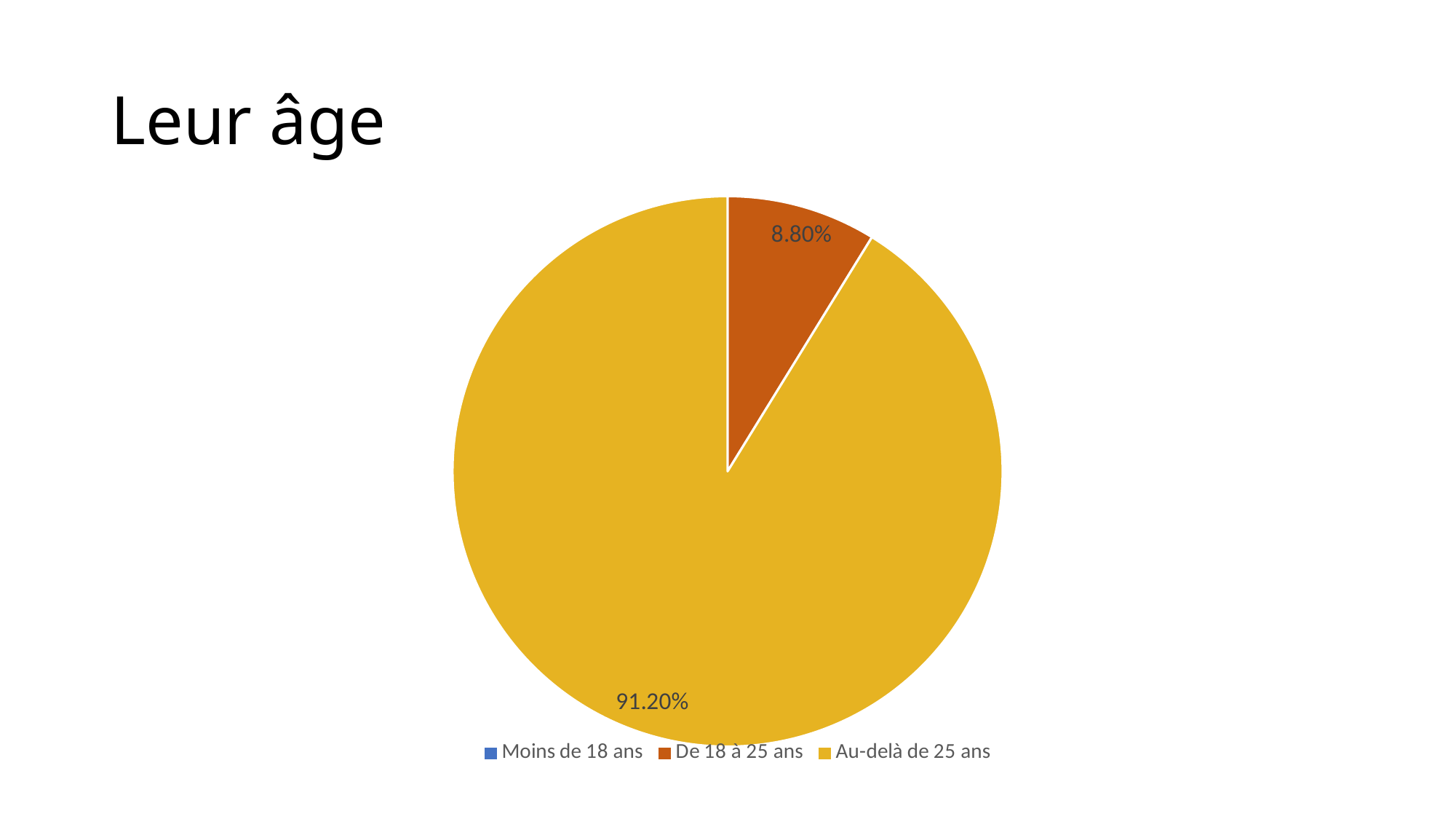
Is the share for 'Au-delà de 25 ans' greater or less than 50%? greater What kind of chart is shown on the slide? Pie chart Which slice is larger, 'De 18 à 25 ans' or 'Au-delà de 25 ans'? Au-delà de 25 ans How many categories does the legend list? 3 Which category has the largest slice of the pie? Au-delà de 25 ans What colour is the 'Au-delà de 25 ans' slice? Yellow What is the difference in percentage points between the 'Au-delà de 25 ans' slice and the 'De 18 à 25 ans' slice? 82.40% What is the title of the slide? Leur âge What percentage of the pie does the 'Au-delà de 25 ans' slice represent? 91.20% What percentage of the pie does the 'De 18 à 25 ans' slice represent? 8.80% Is the share for 'De 18 à 25 ans' greater or less than 10%? less